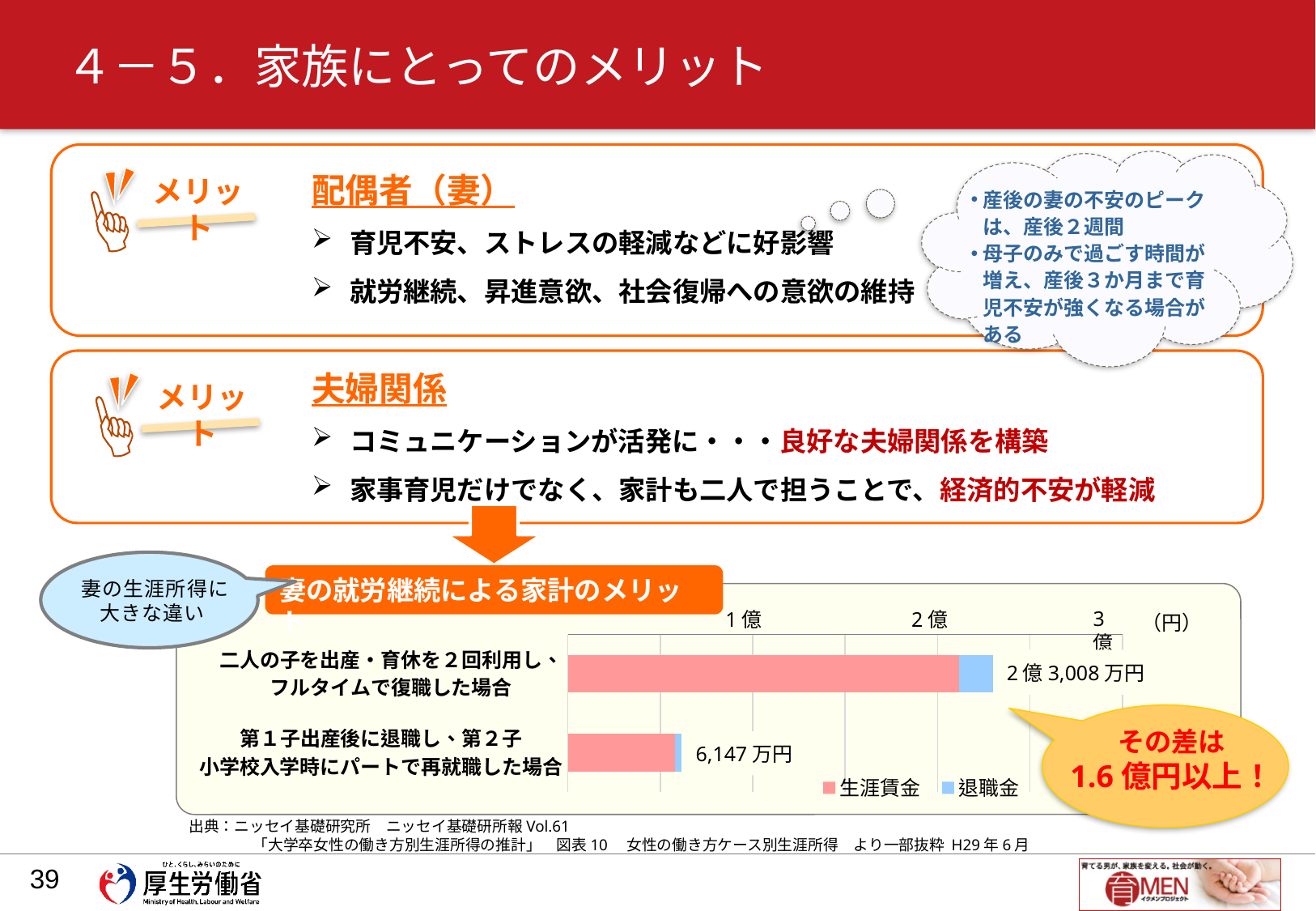
What is the value shown for 第１子出産後に退職し、第２子小学校入学時にパートで再就職した場合? 6,147万円 Which case has the lower total lifetime income in the chart? 第１子出産後に退職し、第２子小学校入学時にパートで再就職した場合 What are the two legend entries of the chart? 生涯賃金 and 退職金 Is the value for 第１子出産後に退職し、第２子小学校入学時にパートで再就職した場合 greater or less than 1億? less Is the value for 二人の子を出産・育休を２回利用し、フルタイムで復職した場合 greater or less than 2億? greater What is the value shown for 二人の子を出産・育休を２回利用し、フルタイムで復職した場合? 2億3,008万円 What is the difference between the two totals shown in the chart (2億3,008万円 and 6,147万円)? 1億6,861万円 How many cases (categories) are plotted in the chart? 2 How many series does the chart legend list? 2 Which case has the higher total lifetime income in the chart? 二人の子を出産・育休を２回利用し、フルタイムで復職した場合 Is the total for the full-time return case larger or smaller than the total for the part-time re-employment case? larger What kind of chart is shown on the slide? Stacked horizontal bar chart